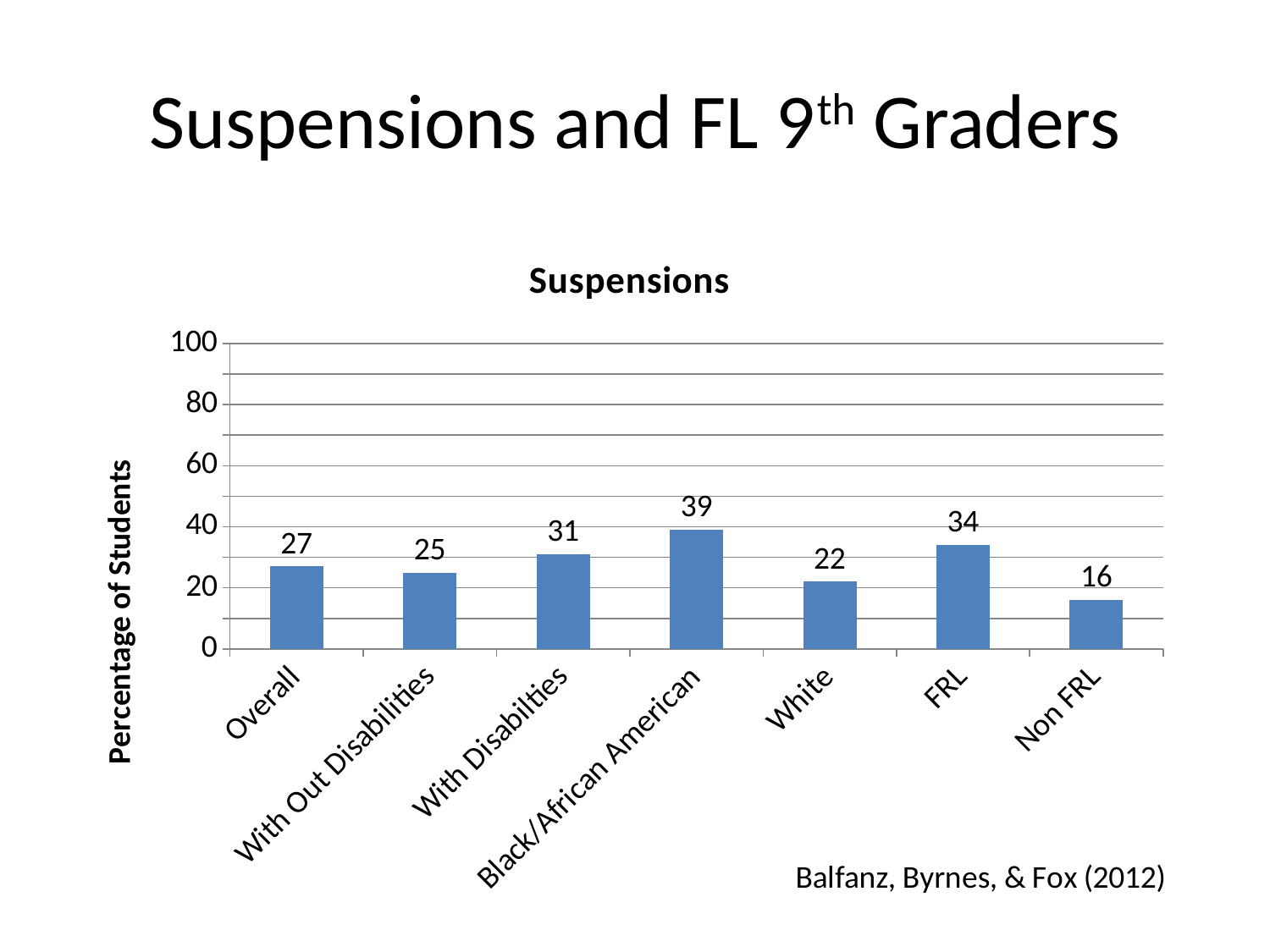
What is the difference between the values for Black/African American and White? 17 Which category has the lowest value in the Suspensions chart? Non FRL Which is larger, the value for With Disabilties or the value for With Out Disabilities? With Disabilties How many categories are shown on the x axis of the Suspensions chart? 7 What is the value for Black/African American in the Suspensions chart? 39 What is the value for With Disabilties in the Suspensions chart? 31 Is the value for Overall greater or less than 40? less What is the label of the vertical axis of the chart? Percentage of Students What is the difference between the values for FRL and Non FRL? 18 What kind of chart is shown on the slide? bar chart Which category has the highest value in the Suspensions chart? Black/African American What is the value for Non FRL in the Suspensions chart? 16